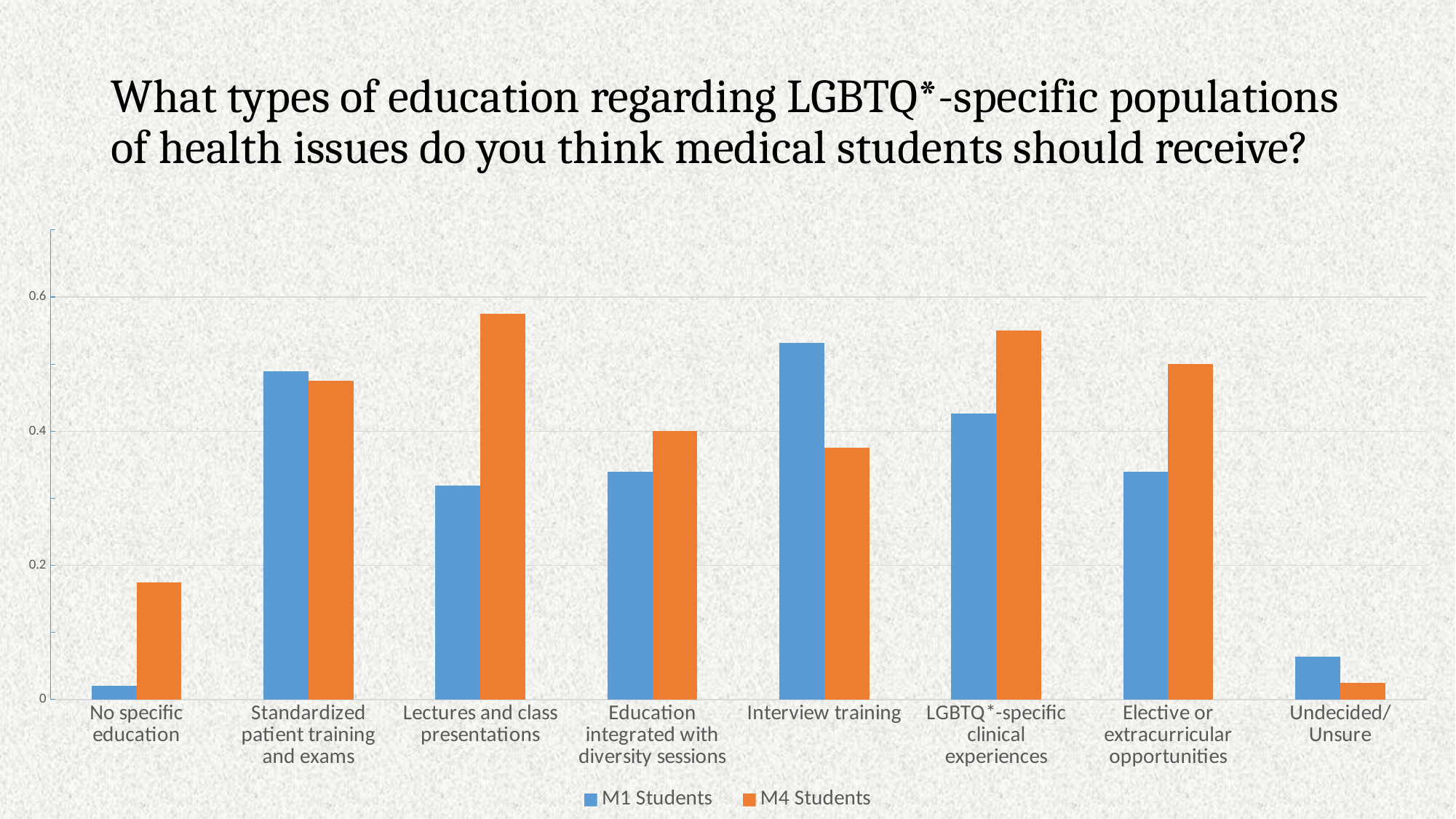
How many education-type categories are shown on the x axis? 8 For Elective or extracurricular opportunities, which series has the larger value, M1 Students or M4 Students? M4 Students What kind of chart is shown on the slide? bar chart Which category has the lowest value for M1 Students? No specific education Which category has the highest value for M4 Students? Lectures and class presentations Which series is shown in orange in the legend? M4 Students Is the M4 Students value for No specific education greater or less than 0.2? less Is the M4 Students value for Lectures and class presentations greater or less than 0.4? greater Which category has the lowest value for M4 Students? Undecided/Unsure Is the M1 Students value for Interview training greater or less than 0.4? greater Which category has the highest value for M1 Students? Interview training How many series does the legend list? 2